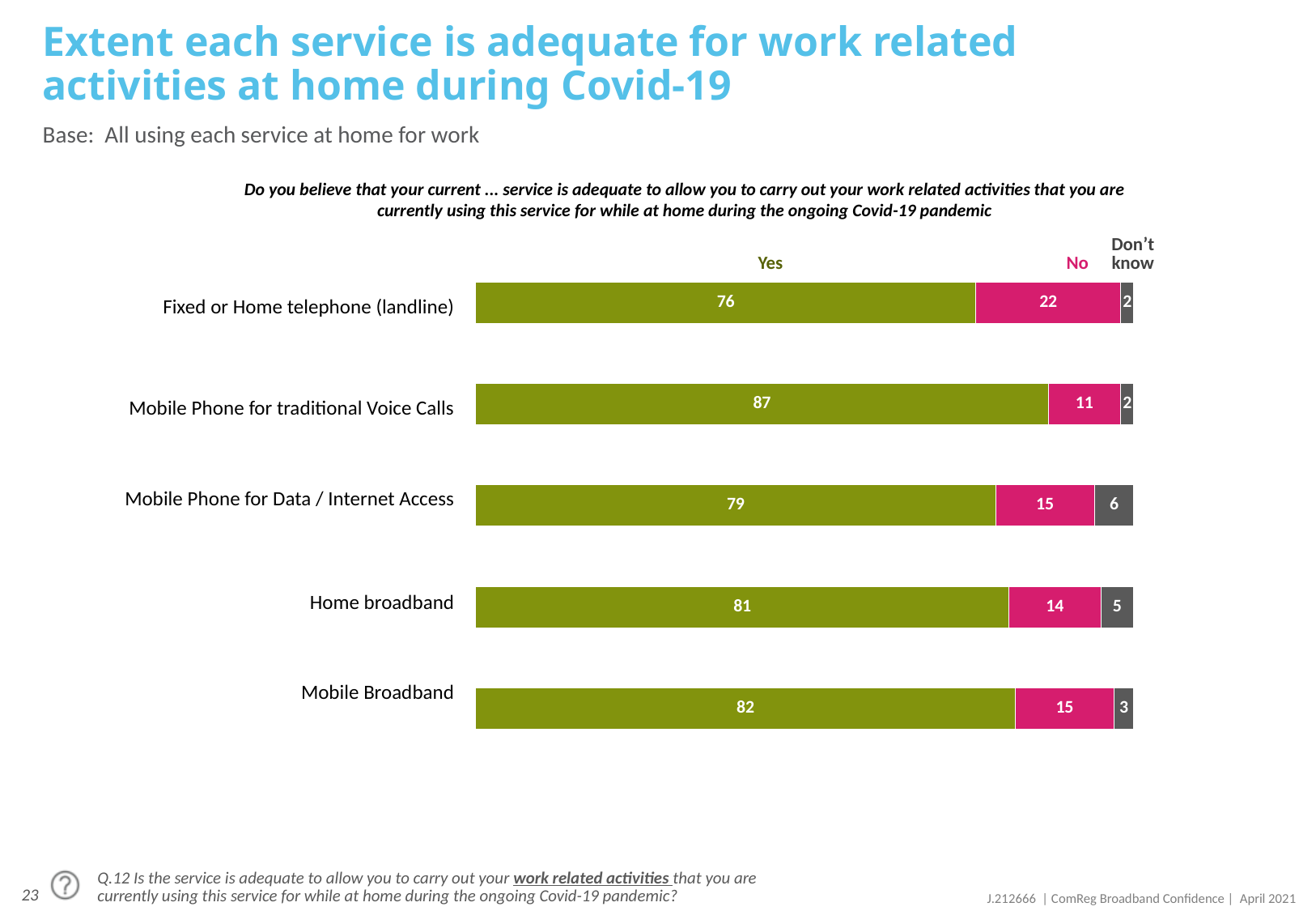
What is the difference between the 'Yes' values for Mobile Phone for traditional Voice Calls and Fixed or Home telephone (landline)? 11 What type of chart is shown on the slide? Stacked bar chart What is the 'Yes' value for Mobile Phone for traditional Voice Calls? 87 Which is larger: the 'No' value for Home broadband or the 'No' value for Mobile Broadband? Mobile Broadband Which service has the highest 'Yes' value? Mobile Phone for traditional Voice Calls How many response categories (series) does the chart show? 3 What is the 'No' value for Fixed or Home telephone (landline)? 22 What is the 'Yes' value for Home broadband? 81 Which service has the lowest 'Yes' value? Fixed or Home telephone (landline) Which service has the highest 'No' value? Fixed or Home telephone (landline) What is the 'Don't know' value for Mobile Phone for Data / Internet Access? 6 How many services are shown in the chart? 5